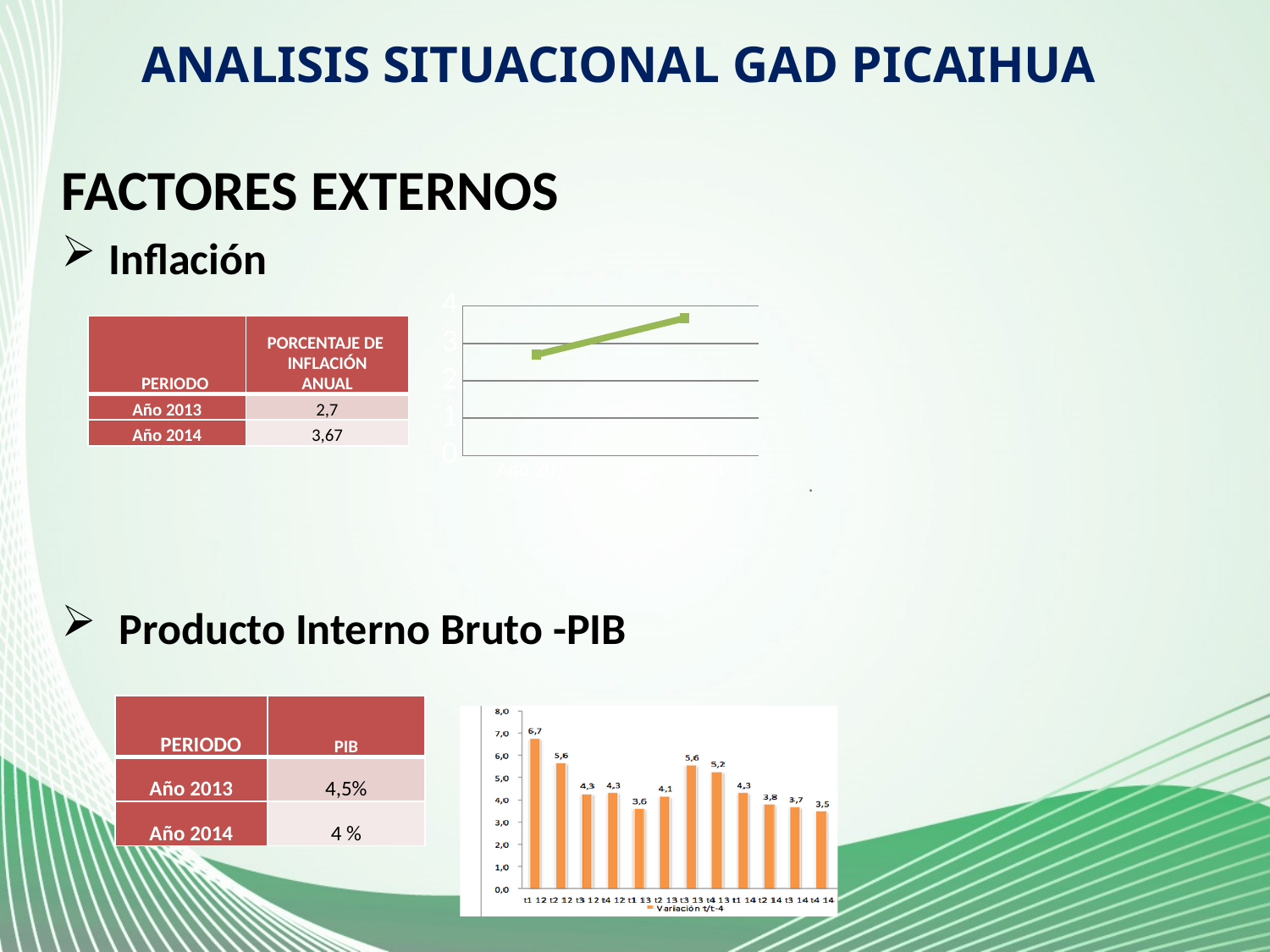
In the bar chart under Producto Interno Bruto -PIB, which category has the lowest value? t4 14 What type of chart is the chart next to the Inflación table? line chart In the bar chart under Producto Interno Bruto -PIB, which category has the highest value? t1 12 In the bar chart under Producto Interno Bruto -PIB, what is the value for t1 13? 3,6 In the bar chart under Producto Interno Bruto -PIB, what is the difference between the values for t1 12 and t4 14? 3,2 How many bars are plotted in the bar chart under Producto Interno Bruto -PIB? 12 What type of chart is the chart at the bottom right of the slide (under Producto Interno Bruto -PIB)? bar chart In the line chart next to the Inflación table, does the line rise or fall from left to right? rise In the bar chart under Producto Interno Bruto -PIB, which is larger, the value for t3 13 or the value for t2 14? t3 13 In the bar chart under Producto Interno Bruto -PIB, what is the value for t1 12? 6,7 In the bar chart under Producto Interno Bruto -PIB, what is the value for t4 13? 5,2 What is the legend entry shown in the bar chart under Producto Interno Bruto -PIB? Variación t/t-4